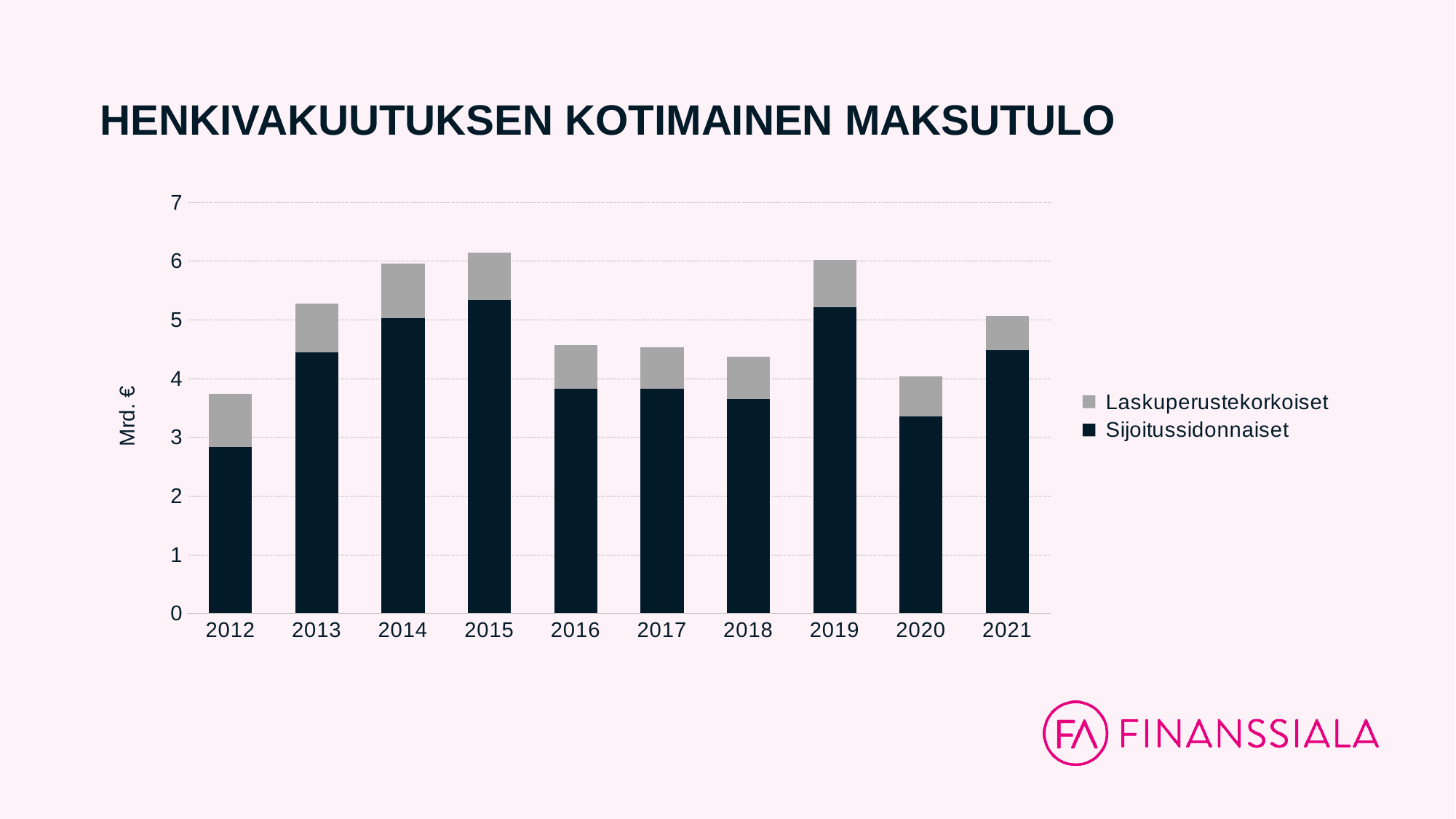
What kind of chart is shown on the slide? Stacked bar chart Is the Sijoitussidonnaiset value for 2019 greater or less than 5? greater What is the label on the y axis? Mrd. € Is the total value for 2015 greater or less than 6? greater Which year has the lowest total bar? 2012 Is the total value for 2018 greater or less than 5? less Do the total bars rise or fall from 2016 to 2018? fall Which year has the larger total bar, 2013 or 2016? 2013 How many years are shown on the x axis? 10 Which year has the highest total bar? 2015 How many series does the legend list? 2